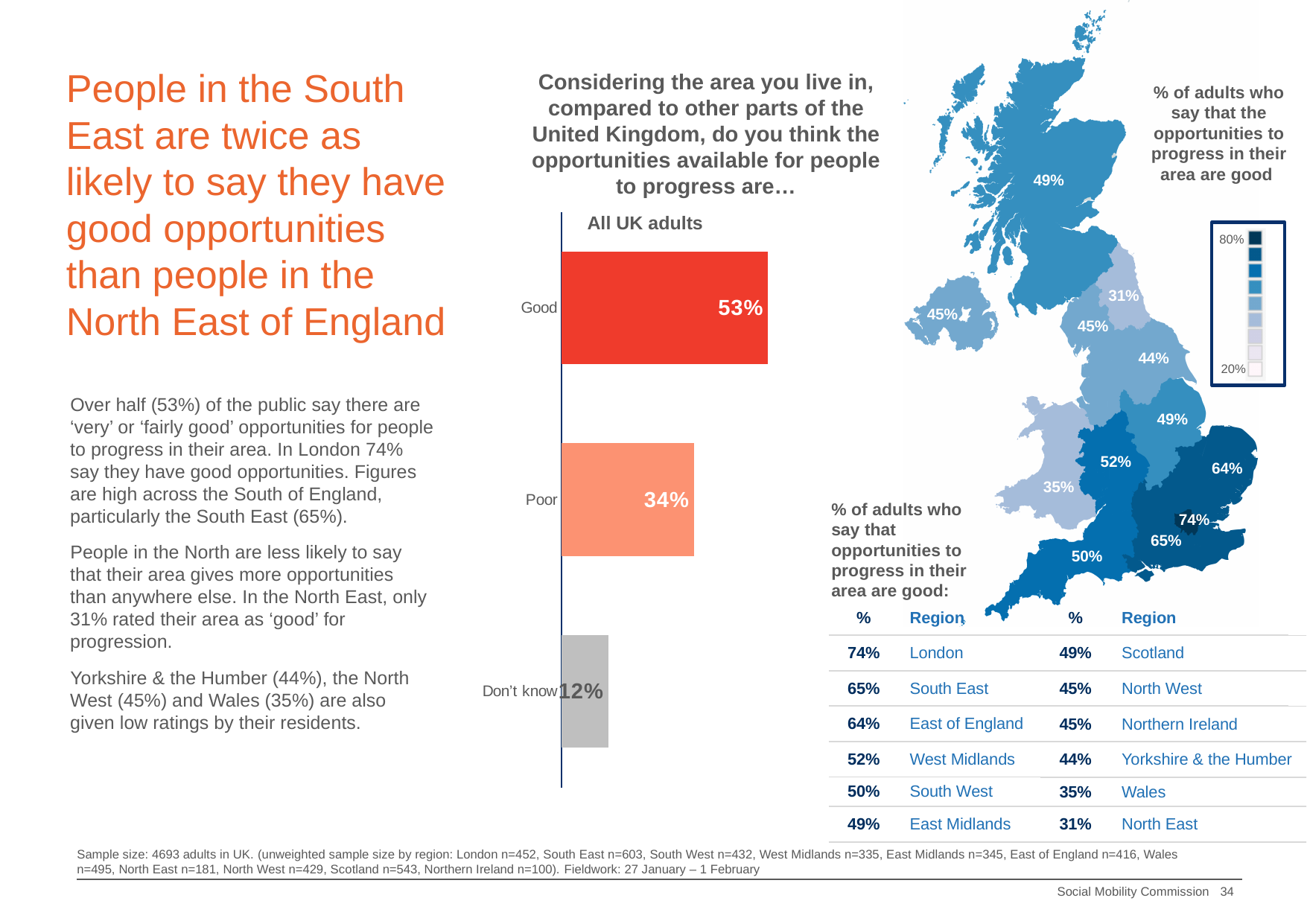
In the 'All UK adults' bar chart, what is the value for 'Don't know'? 12% In the 'All UK adults' bar chart, what is the value for 'Poor'? 34% In the 'All UK adults' bar chart, which category has the lowest value? Don't know In the 'All UK adults' bar chart, what colour is the 'Don't know' bar? Grey In the 'All UK adults' bar chart, what is the difference between the 'Good' and 'Poor' values? 19 percentage points In the 'All UK adults' bar chart, what percentage of adults say opportunities to progress in their area are good? 53% In the 'All UK adults' bar chart, which is larger, 'Poor' or 'Don't know'? Poor What kind of chart is the 'All UK adults' chart? Bar chart In the 'All UK adults' bar chart, which category has the highest value? Good How many categories are shown in the 'All UK adults' bar chart? 3 On the UK map, which region has the highest percentage of adults saying opportunities to progress in their area are good? London (74%) On the UK map, what percentage is shown for Wales? 35%